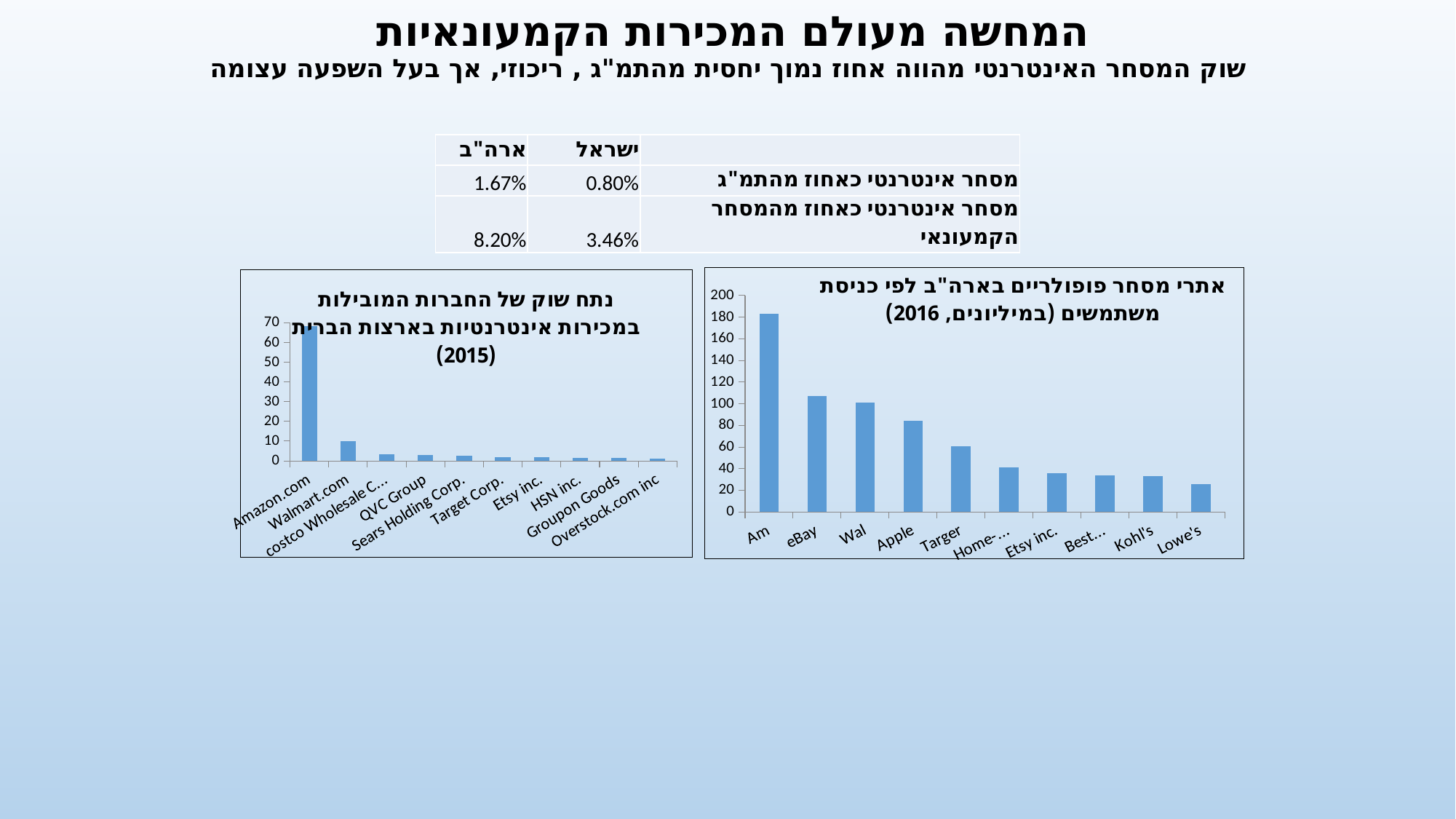
In the left chart (market share of leading companies in US internet sales, 2015), which company has the highest value? Amazon.com How many sites are shown in the right chart (popular commerce sites in the US by user entries, millions, 2016)? 10 How many companies are shown in the left chart (market share of leading companies in US internet sales, 2015)? 10 What kind of chart is the left chart (market share of leading companies in US internet sales, 2015)? bar chart What kind of chart is the right chart (popular commerce sites in the US by user entries, millions, 2016)? bar chart In the right chart (popular commerce sites in the US by user entries, millions, 2016), is the value for Apple greater or less than 100? less In the left chart (market share of leading companies in US internet sales, 2015), which is larger, the value for Walmart.com or the value for QVC Group? Walmart.com In the right chart (popular commerce sites in the US by user entries, millions, 2016), do the values rise or fall from left to right along the x axis? fall In the right chart (popular commerce sites in the US by user entries, millions, 2016), is the value for eBay greater or less than 100? greater In the left chart (market share of leading companies in US internet sales, 2015), is the value for Walmart.com greater or less than 20? less In the right chart (popular commerce sites in the US by user entries, millions, 2016), which site has the lowest value? Lowe's